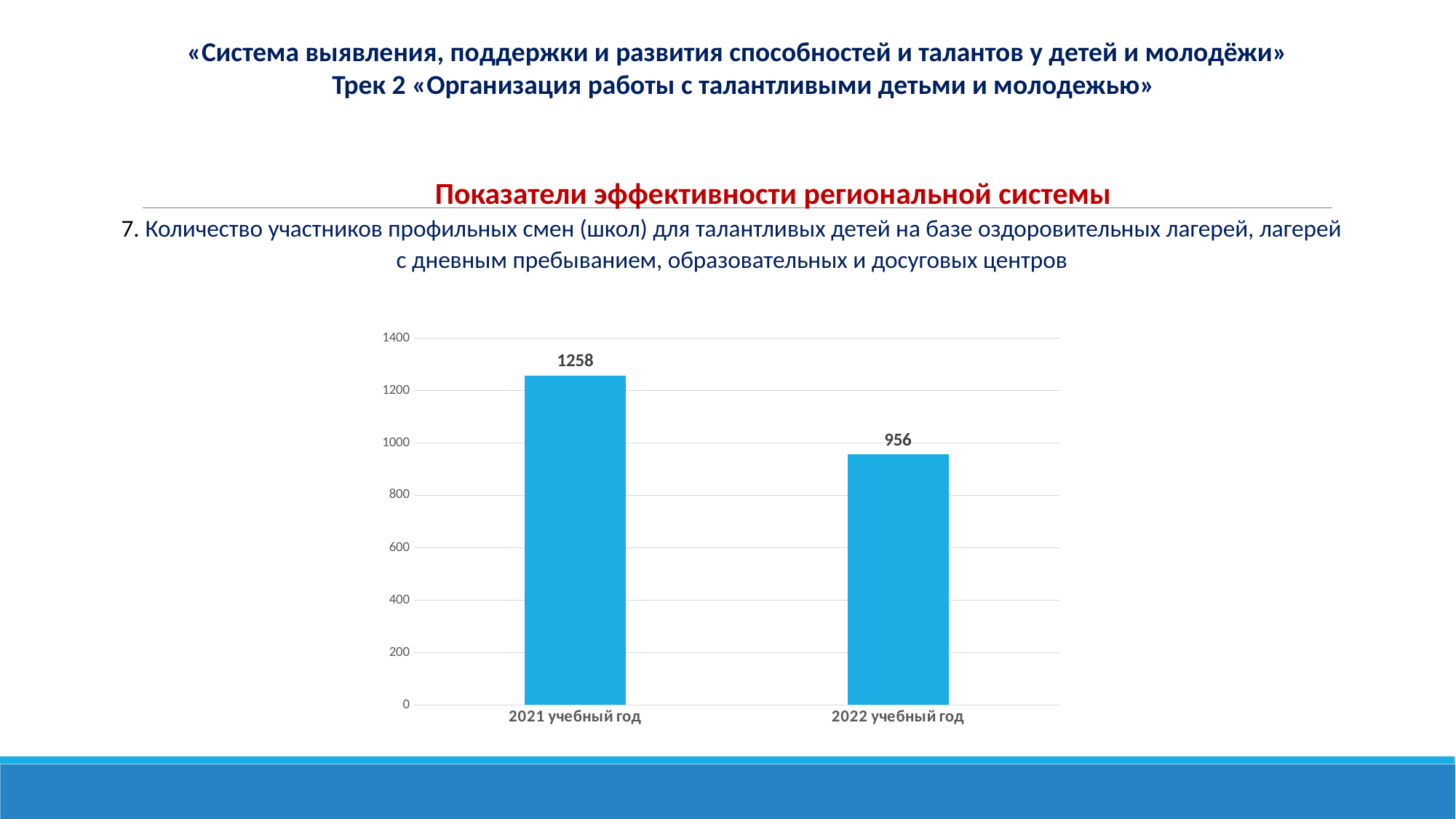
Which category has the lowest value? 2022 учебный год Which is larger, the value for 2021 учебный год or for 2022 учебный год? 2021 учебный год What is the value for 2022 учебный год? 956 What kind of chart is shown on the slide? bar chart Which category has the highest value? 2021 учебный год Is the value for 2021 учебный год greater or less than 1200? greater What is the difference between the values for 2021 учебный год and 2022 учебный год? 302 Is the value for 2022 учебный год greater or less than 1000? less What is the highest value shown on the vertical axis? 1400 What is the value for 2021 учебный год? 1258 Do the values rise or fall from 2021 учебный год to 2022 учебный год? fall How many categories are shown on the x axis? 2